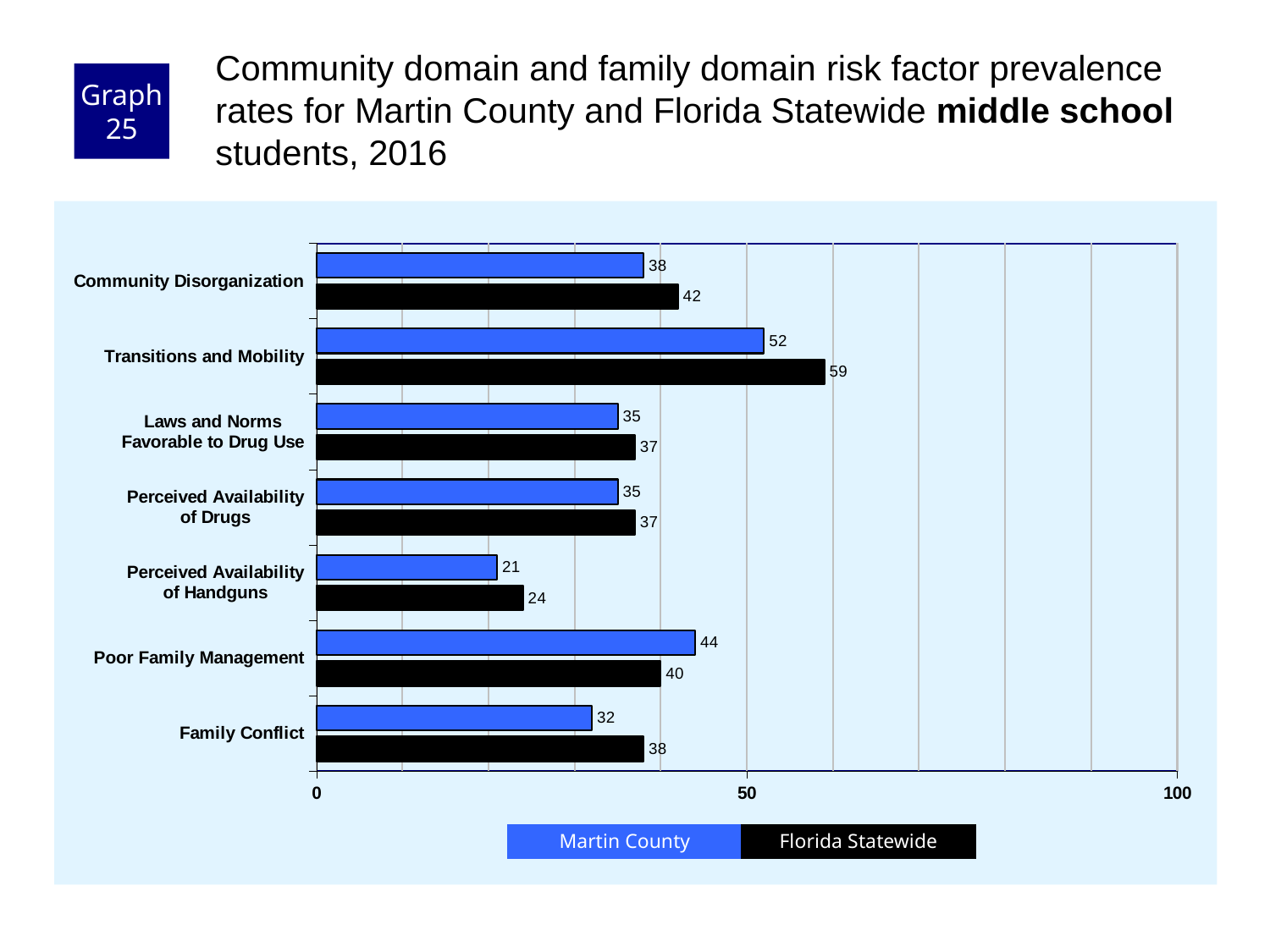
How many risk factor categories are shown on the chart? 7 What is the Martin County value for Transitions and Mobility? 52 Which risk factor has the lowest Martin County value? Perceived Availability of Handguns What kind of chart is shown on the slide? bar chart Is the Florida Statewide value for Transitions and Mobility greater or less than 50? greater Which colour represents Florida Statewide in the chart? black What is the Florida Statewide value for Perceived Availability of Handguns? 24 For Poor Family Management, which is larger: the Martin County value or the Florida Statewide value? Martin County How many series does the legend list? 2 What is the Florida Statewide value for Family Conflict? 38 What is the difference between the Florida Statewide and Martin County values for Transitions and Mobility? 7 Which risk factor has the highest Florida Statewide value? Transitions and Mobility